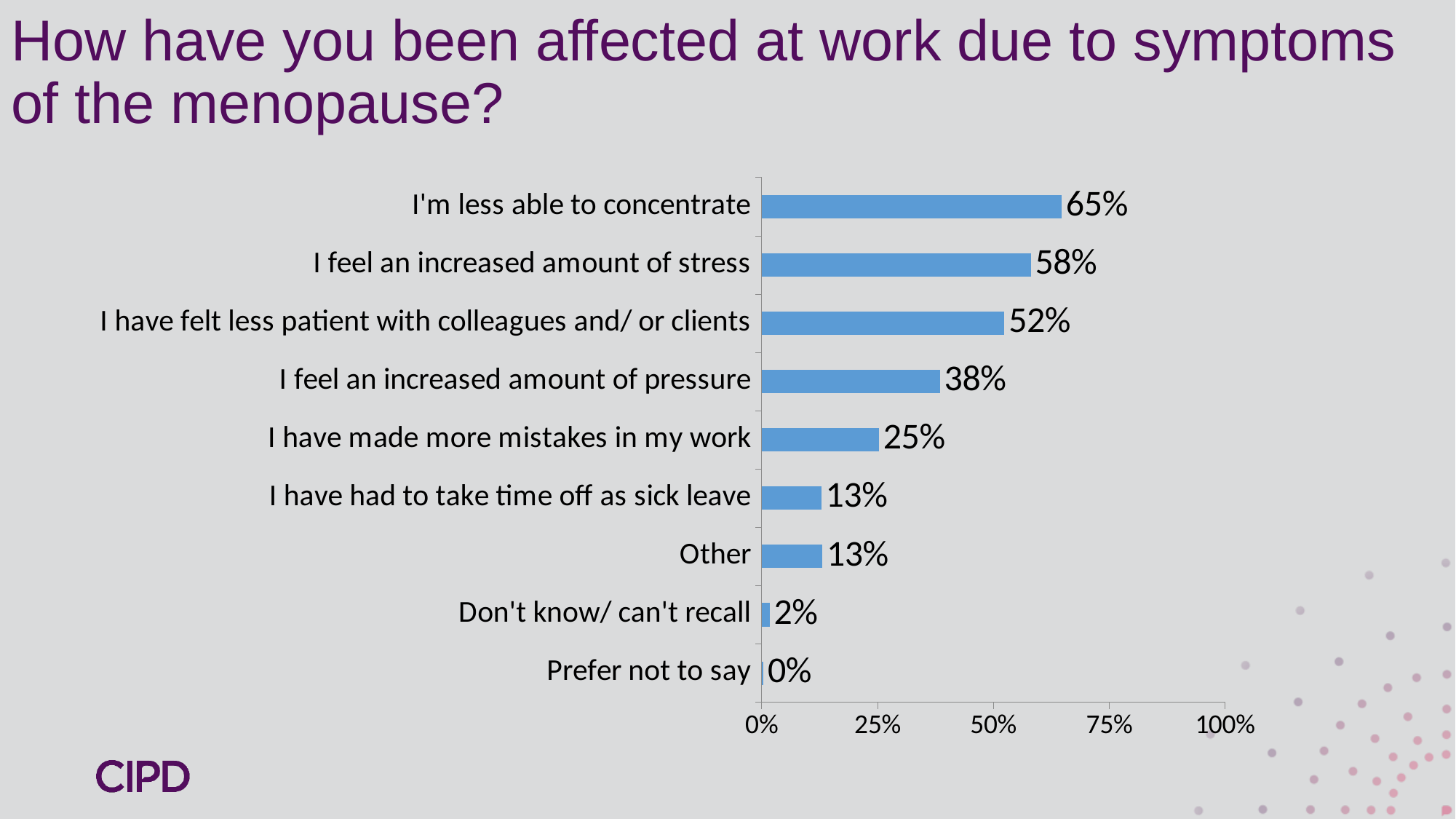
Is the value for 'I feel an increased amount of stress' greater or less than 50%? greater Which is larger: 'I have felt less patient with colleagues and/ or clients' or 'I feel an increased amount of pressure'? I have felt less patient with colleagues and/ or clients Which category has the lowest value? Prefer not to say Which category has the highest value? I'm less able to concentrate How many categories are shown in the chart? 9 What is the title of the slide? How have you been affected at work due to symptoms of the menopause? What percentage of respondents said they are less able to concentrate? 65% What is the value for 'I have made more mistakes in my work'? 25% What percentage said they have had to take time off as sick leave? 13% What kind of chart is shown on the slide? Bar chart What is the value for 'Don't know/ can't recall'? 2% What is the difference between 'I feel an increased amount of stress' and 'I feel an increased amount of pressure'? 20%